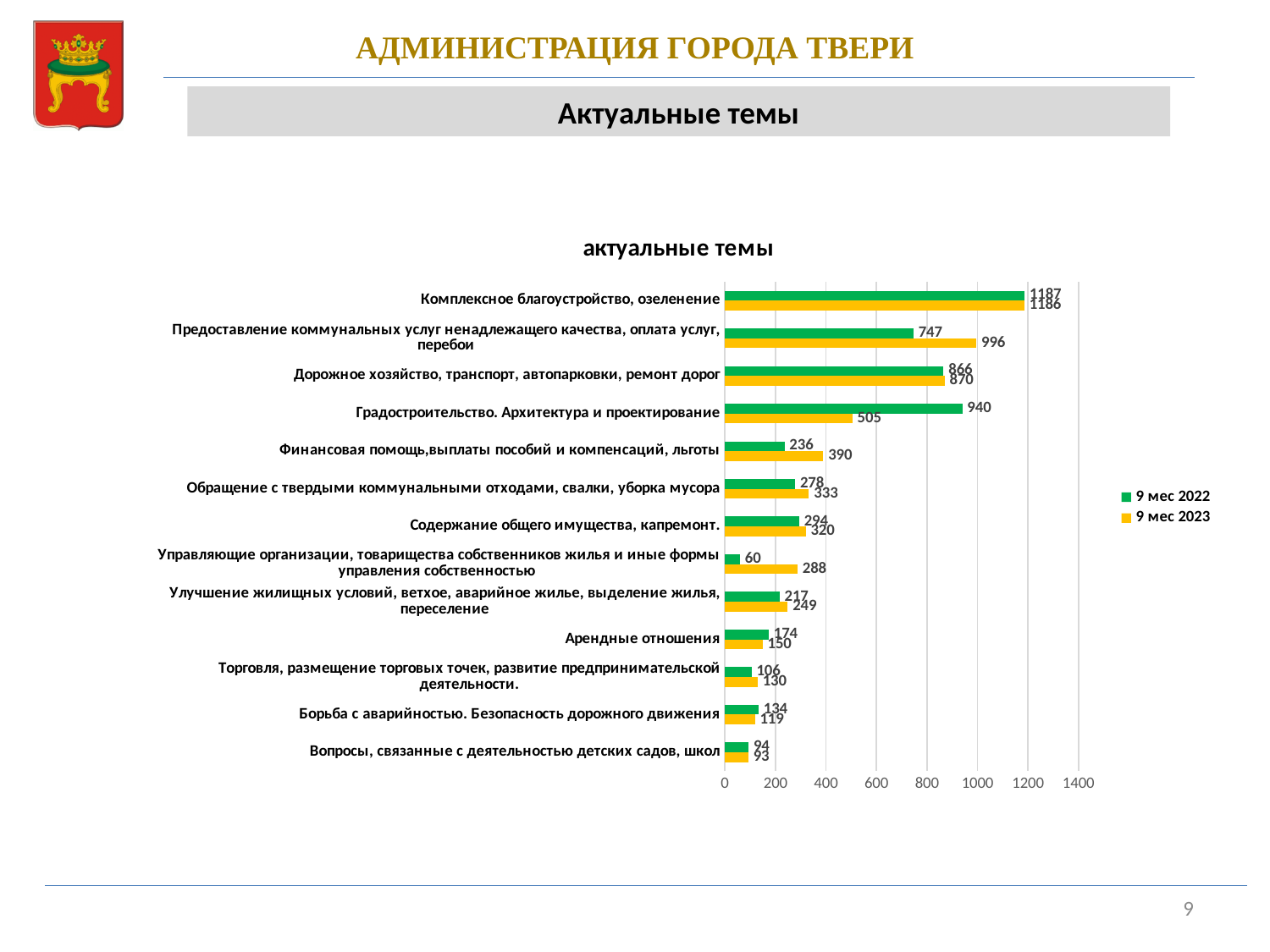
What is the value for "Предоставление коммунальных услуг ненадлежащего качества, оплата услуг, перебои" in the "9 мес 2023" series? 996 What type of chart is shown on the slide? bar chart For "Градостроительство. Архитектура и проектирование", which series has the larger value, "9 мес 2022" or "9 мес 2023"? 9 мес 2022 What is the difference between the "9 мес 2023" and "9 мес 2022" values for "Финансовая помощь,выплаты пособий и компенсаций, льготы"? 154 How many categories are shown in the chart? 13 What is the value for "Управляющие организации, товарищества собственников жилья и иные формы управления собственностью" in the "9 мес 2022" series? 60 Which category has the highest value in the "9 мес 2023" series? Комплексное благоустройство, озеленение How many series does the legend list? 2 Which category has the lowest value in the "9 мес 2022" series? Управляющие организации, товарищества собственников жилья и иные формы управления собственностью What is the title of the chart? актуальные темы Is the "9 мес 2022" value for "Дорожное хозяйство, транспорт, автопарковки, ремонт дорог" greater or less than 800? greater What is the value for "Градостроительство. Архитектура и проектирование" in the "9 мес 2022" series? 940